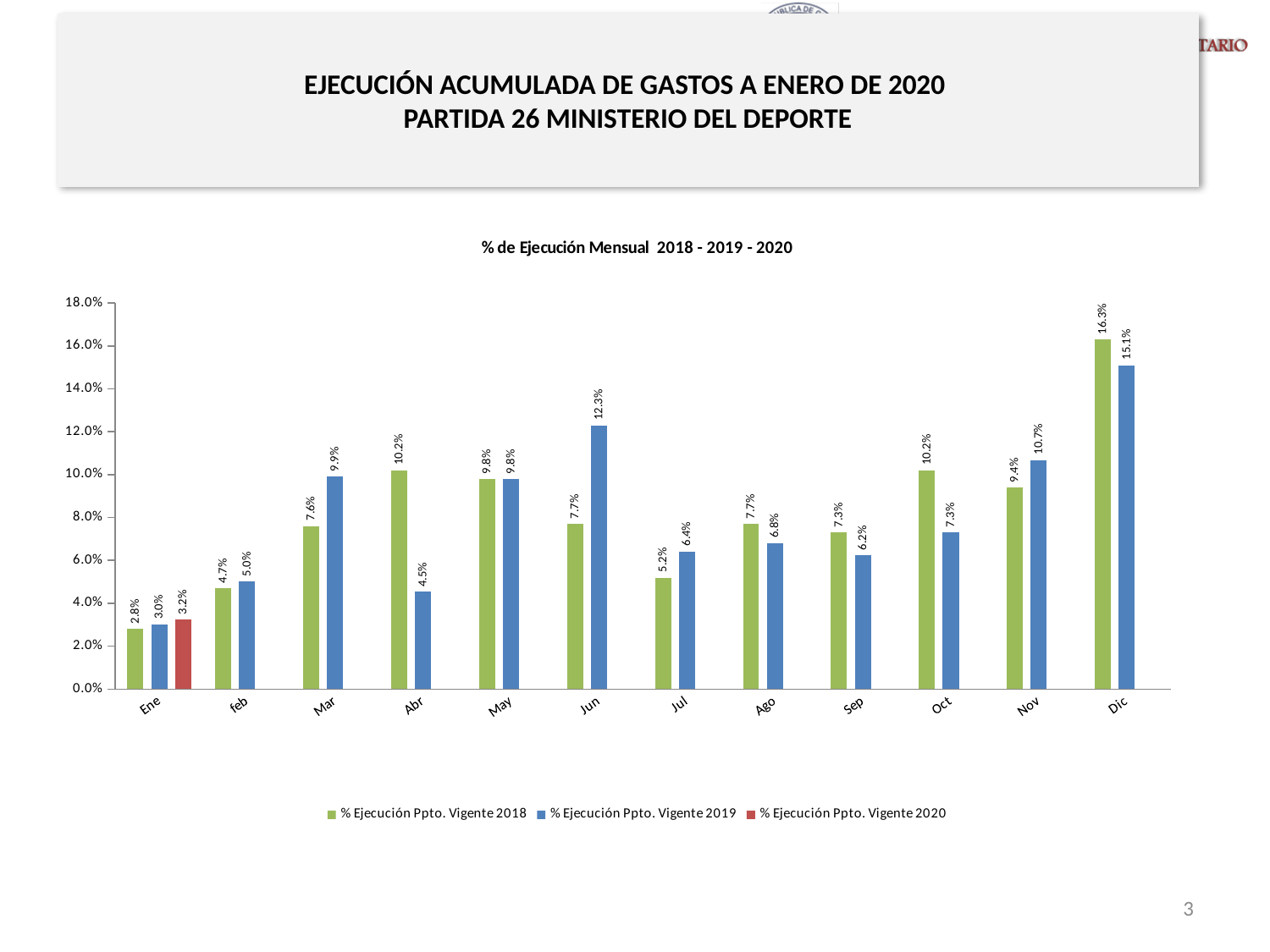
What kind of chart is shown on the slide? Bar chart What is the value for % Ejecución Ppto. Vigente 2018 in Abr? 10.2% In Abr, which series has the larger value, 2018 or 2019? % Ejecución Ppto. Vigente 2018 What is the value for % Ejecución Ppto. Vigente 2020 in Ene? 3.2% What is the difference between the 2018 and 2019 values in Dic? 1.2% Is the value for % Ejecución Ppto. Vigente 2019 in Nov greater or less than 10.0%? greater What is the value for % Ejecución Ppto. Vigente 2019 in Jun? 12.3% Which month has the lowest value for % Ejecución Ppto. Vigente 2019? Ene What is the title of the chart? % de Ejecución Mensual 2018 - 2019 - 2020 Which month has the highest value for % Ejecución Ppto. Vigente 2018? Dic How many series does the legend list? 3 How many months are shown on the x axis? 12